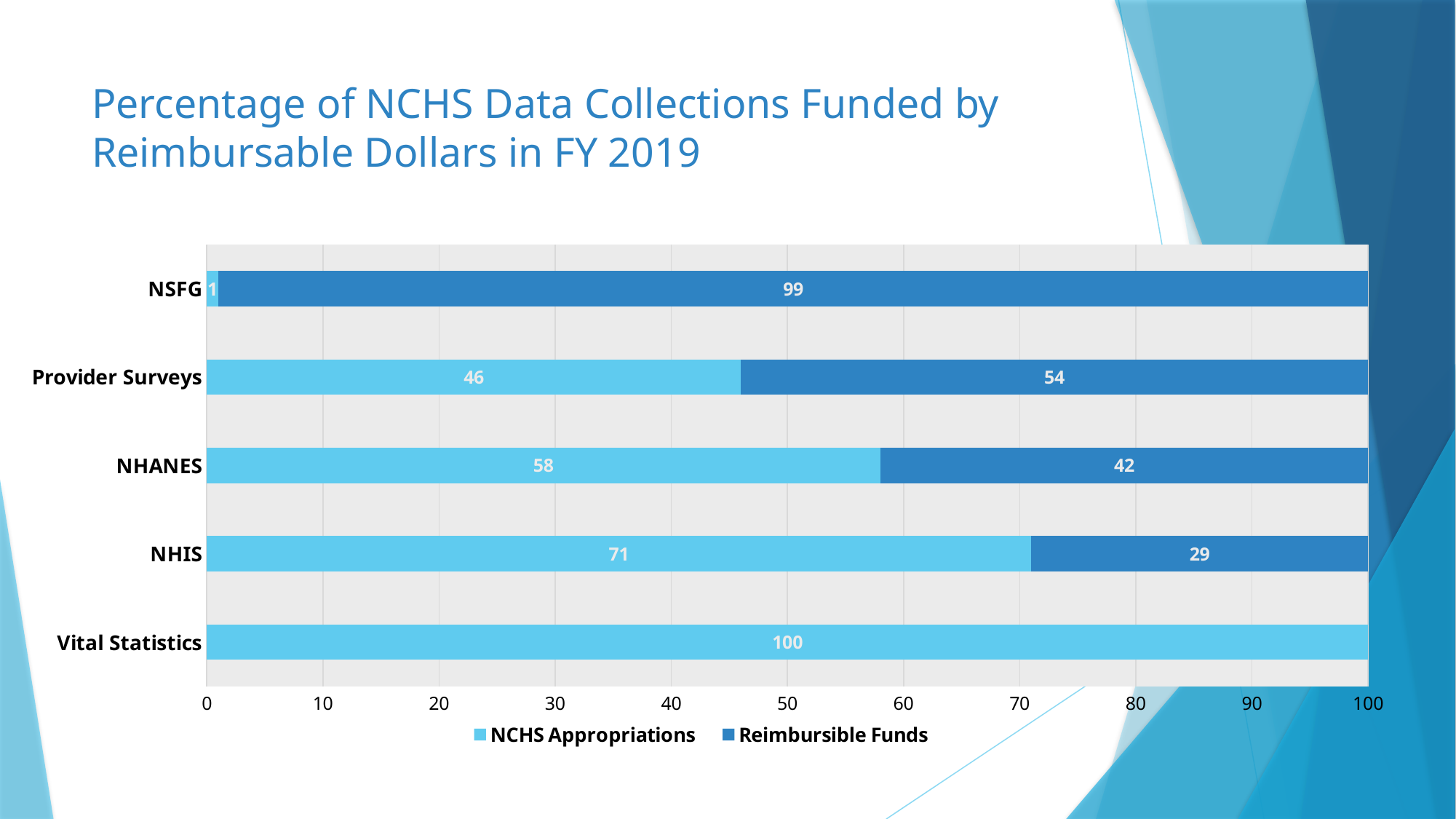
What is the NCHS Appropriations value for NHANES? 58 How many series does the legend list? 2 Which is larger: the NCHS Appropriations value for NHIS or for Provider Surveys? NHIS How many categories are shown on the chart? 5 What is the total of the stacked bar for Provider Surveys? 100 What is the difference between the Reimbursible Funds values for Provider Surveys and NHANES? 12 Which category has the lowest NCHS Appropriations value? NSFG What kind of chart is shown on the slide? Stacked bar chart Which category has the highest Reimbursible Funds value? NSFG What is the NCHS Appropriations value for Vital Statistics? 100 What is the Reimbursible Funds value for NSFG? 99 What is the Reimbursible Funds value for NHIS? 29